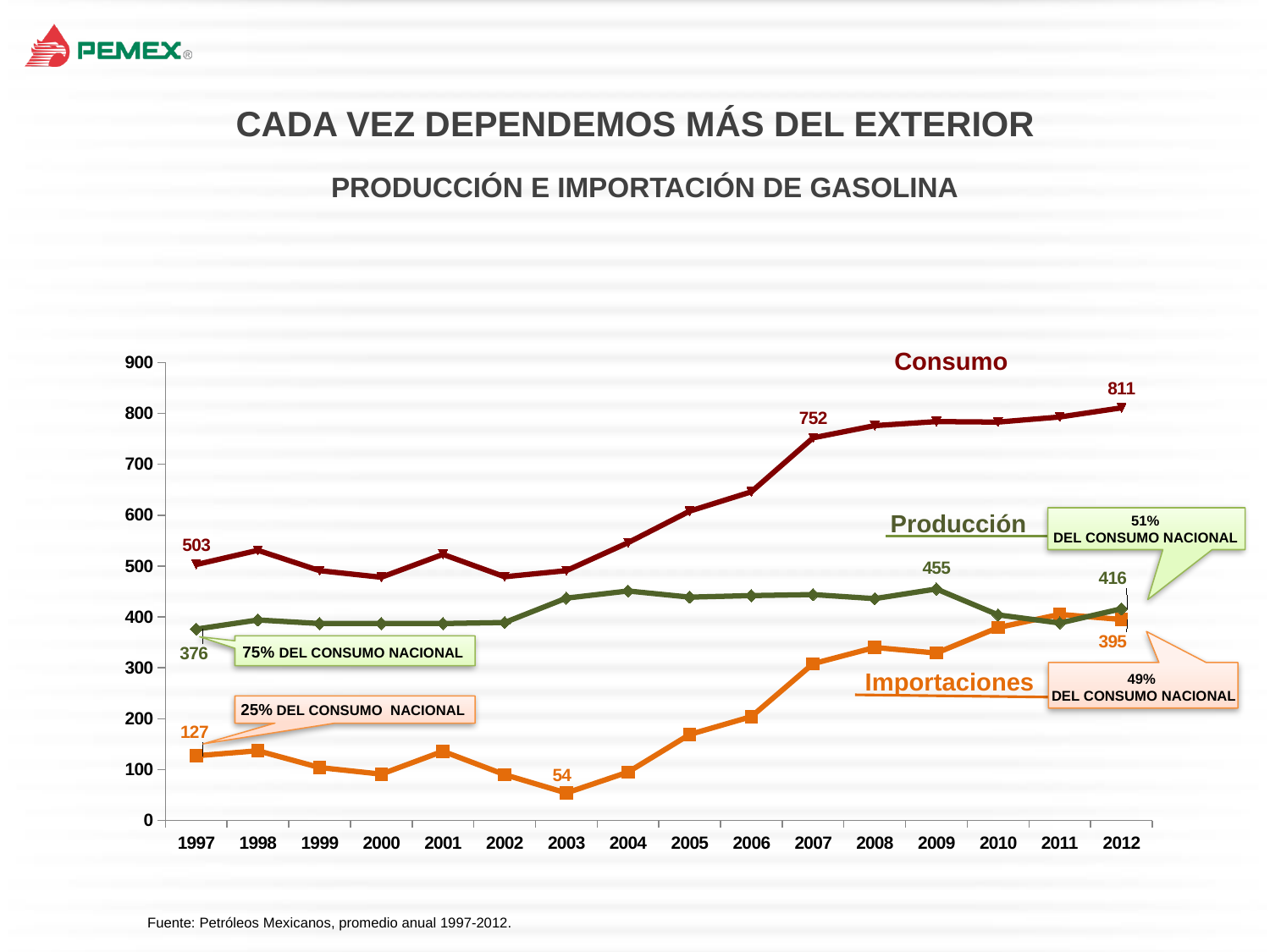
Is the value of Importaciones in 2008 greater or less than 300? greater What is the difference between Producción and Importaciones in 2012? 21 What is the difference between Consumo in 2012 and Consumo in 1997? 308 What is the value of Producción in 2009? 455 Does Importaciones rise or fall from 2003 to 2012? rise How many years are shown on the x axis? 16 What is the value of Importaciones in 2003? 54 What is the value of Consumo in 2007? 752 Which is larger in 1997: Producción or Importaciones? Producción What is the value of Producción in 1997? 376 What is the value of Consumo in 2012? 811 What type of chart is shown on the slide? line chart